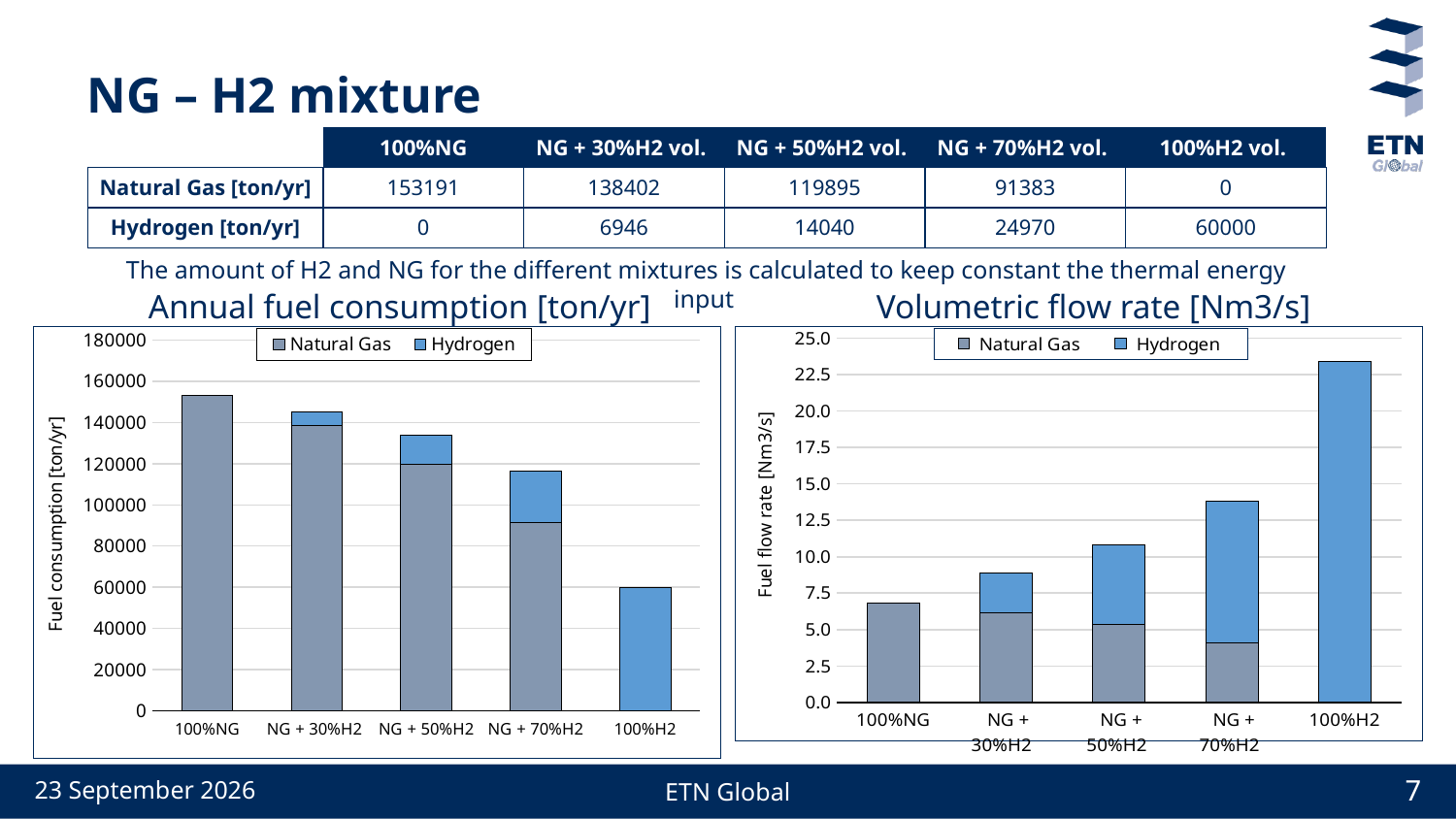
In the Annual fuel consumption [ton/yr] chart, which category has the tallest stacked bar? 100%NG In the Annual fuel consumption [ton/yr] chart, do the total bar heights rise or fall from left to right along the x axis? fall How many categories are shown on the x axis of the Volumetric flow rate [Nm3/s] chart? 5 In the Annual fuel consumption [ton/yr] chart, what is the Hydrogen value for 100%H2? 60000 In the Annual fuel consumption [ton/yr] chart, which category has the shortest stacked bar? 100%H2 In the Volumetric flow rate [Nm3/s] chart, is the value for 100%H2 greater or less than 20.0? greater In the Annual fuel consumption [ton/yr] chart, what is the total of the stacked bar for NG + 30%H2? 145348 How many series does the legend of the Annual fuel consumption [ton/yr] chart list? 2 What kind of chart is the Annual fuel consumption [ton/yr] chart? bar chart In the Volumetric flow rate [Nm3/s] chart, do the total bar heights rise or fall from left to right along the x axis? rise In the Annual fuel consumption [ton/yr] chart, what is the Natural Gas value for 100%NG? 153191 In the Volumetric flow rate [Nm3/s] chart, is the value for 100%NG greater or less than 7.5? less